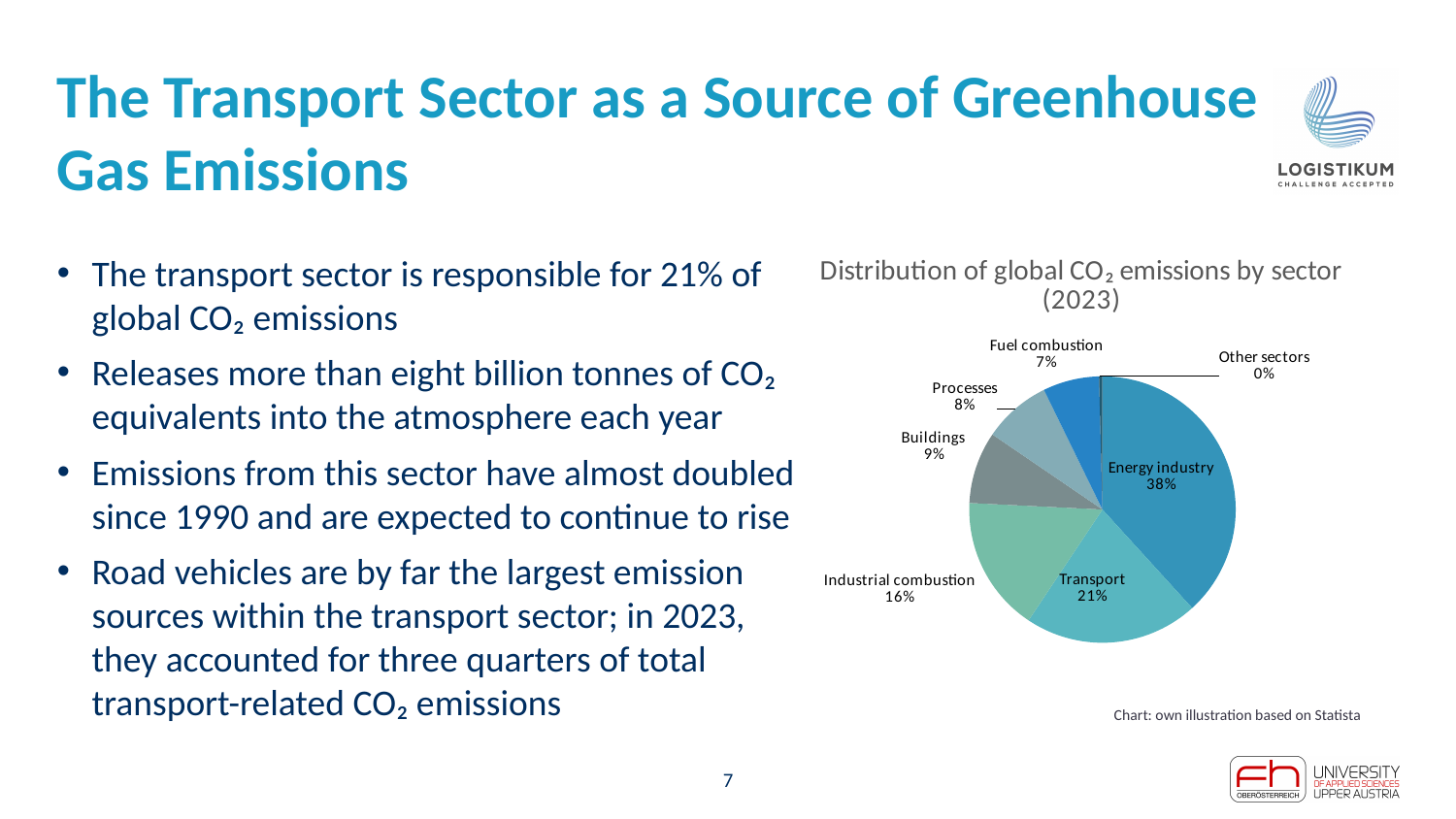
What percentage is shown for Transport in the pie chart? 21% Which sector has the smallest share in the pie chart? Other sectors Which has a larger share, Processes or Buildings? Buildings What percentage is shown for Industrial combustion? 16% What type of chart is shown on the slide? pie chart Which sector has the largest share of global CO₂ emissions in the pie chart? Energy industry What is the title of the chart? Distribution of global CO₂ emissions by sector (2023) What is the difference in percentage points between the Energy industry and Transport shares? 17 What percentage is shown for Fuel combustion? 7% What percentage is shown for Buildings? 9% How many sectors are shown in the pie chart? 7 What share of global CO₂ emissions does the Energy industry account for in the pie chart? 38%